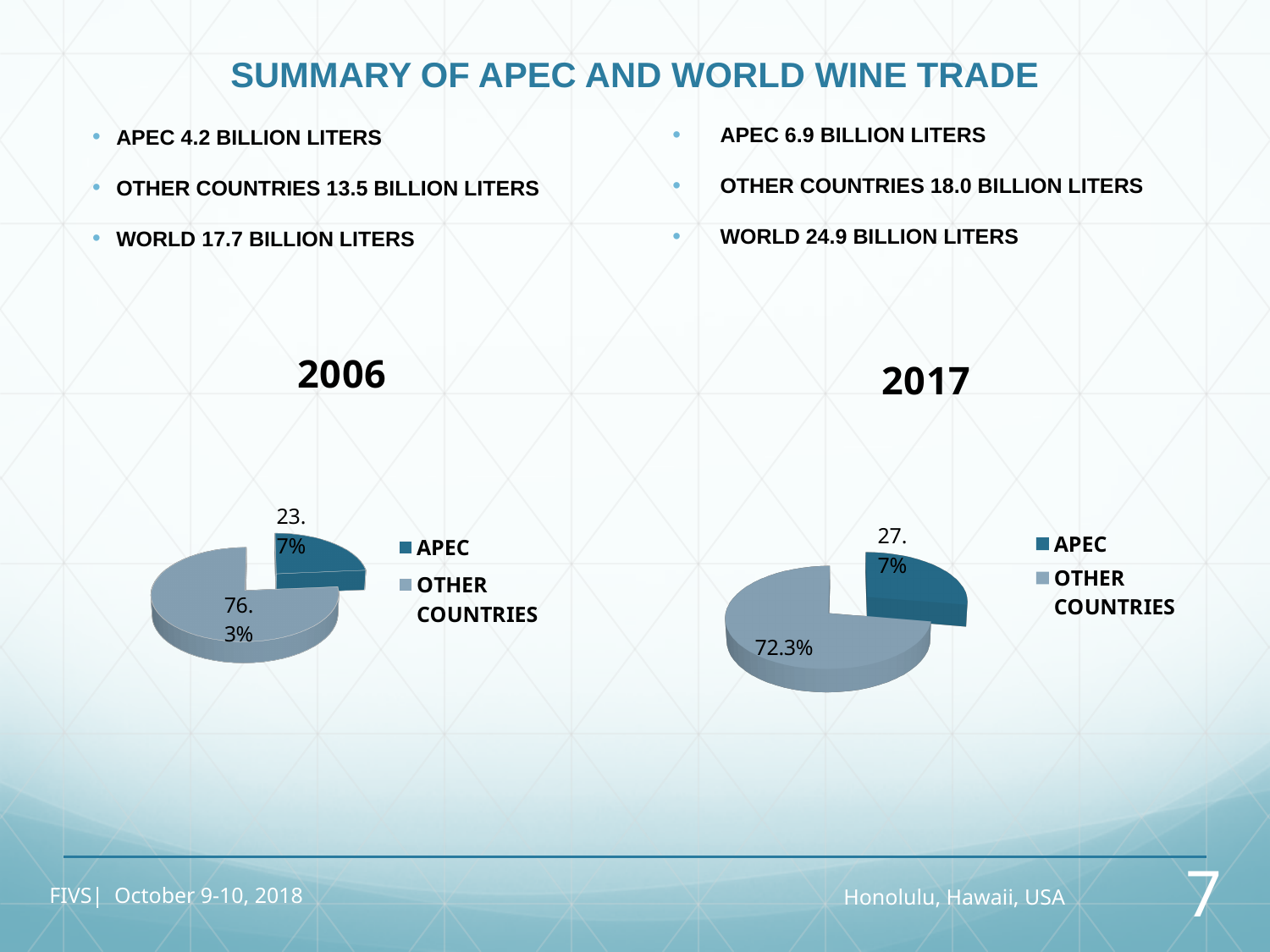
What type of chart is the 2017 chart? Pie chart In the 2017 chart, what share do OTHER COUNTRIES have? 72.3% In the 2017 chart, what share does APEC have? 27.7% In the 2017 chart, what is the difference between the OTHER COUNTRIES share and the APEC share? 44.6% In the 2006 chart, what share do OTHER COUNTRIES have? 76.3% How many slices does the 2006 chart have? 2 How many entries does the legend of the 2017 chart list? 2 In the 2006 chart, which slice is the largest? OTHER COUNTRIES Is the APEC share larger in the 2006 chart or the 2017 chart? 2017 In the 2006 chart, what share does APEC have? 23.7% In the 2017 chart, which slice is the smallest? APEC In the 2006 chart, what is the difference between the OTHER COUNTRIES share and the APEC share? 52.6%